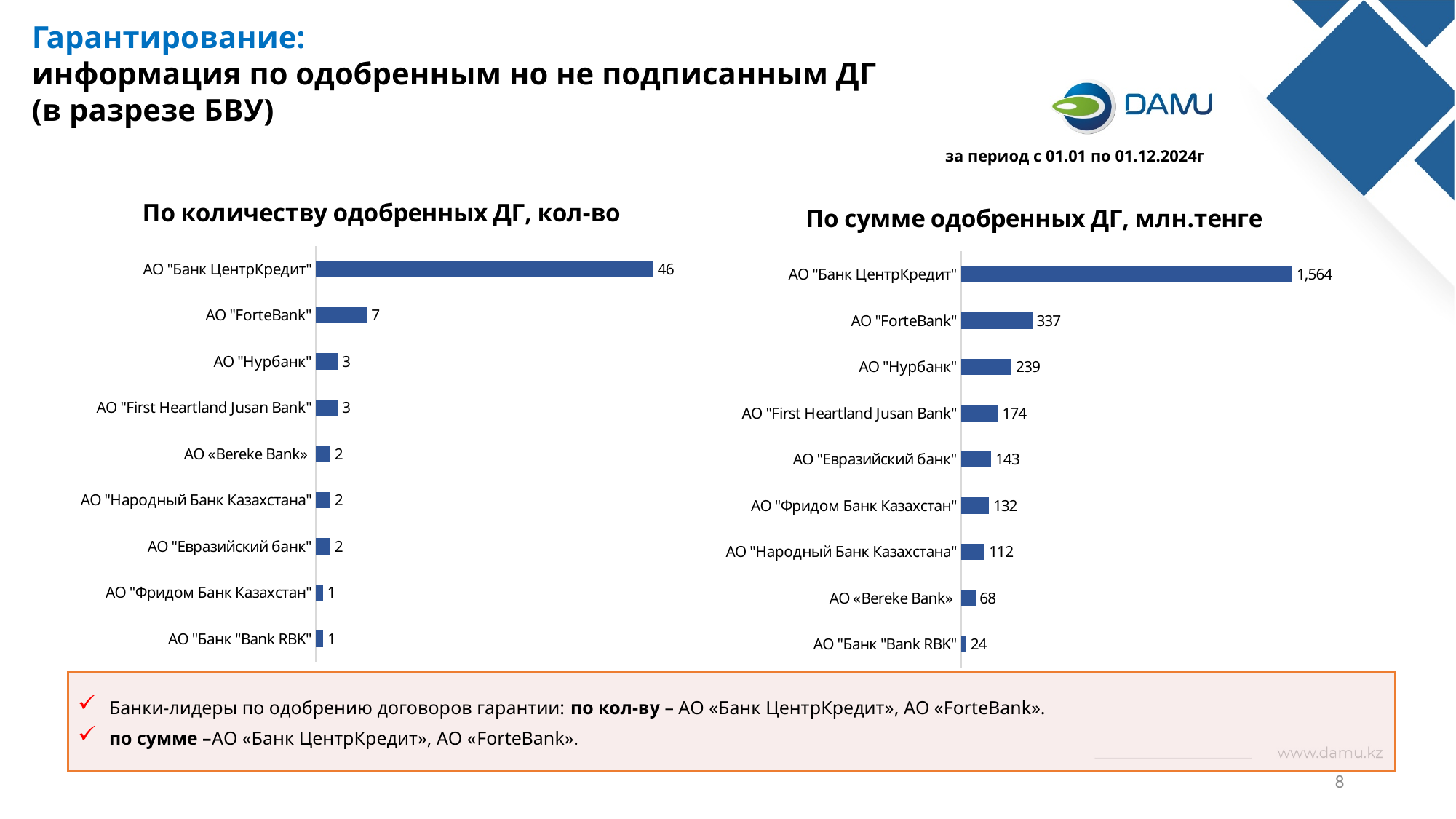
What type of chart is "По сумме одобренных ДГ, млн.тенге"? Bar chart In the chart "По количеству одобренных ДГ, кол-во", what is the difference between АО "Банк ЦентрКредит" and АО "ForteBank"? 39 In the chart "По сумме одобренных ДГ, млн.тенге", which bank has the lowest value? АО "Банк "Bank RBK" In the chart "По сумме одобренных ДГ, млн.тенге", what is the difference between АО "Нурбанк" and АО "First Heartland Jusan Bank"? 65 In the chart "По количеству одобренных ДГ, кол-во", what is the value for АО "Банк ЦентрКредит"? 46 In the chart "По сумме одобренных ДГ, млн.тенге", which bank has the highest value? АО "Банк ЦентрКредит" What period is stated on the slide for the data? за период с 01.01 по 01.12.2024г How many banks are shown in the chart "По количеству одобренных ДГ, кол-во"? 9 In the chart "По сумме одобренных ДГ, млн.тенге", what is the value for АО "ForteBank"? 337 In the chart "По сумме одобренных ДГ, млн.тенге", which is larger: АО "Евразийский банк" or АО "Фридом Банк Казахстан"? АО "Евразийский банк" In the chart "По сумме одобренных ДГ, млн.тенге", what is the value for АО «Bereke Bank»? 68 In the chart "По количеству одобренных ДГ, кол-во", what is the value for АО "Нурбанк"? 3